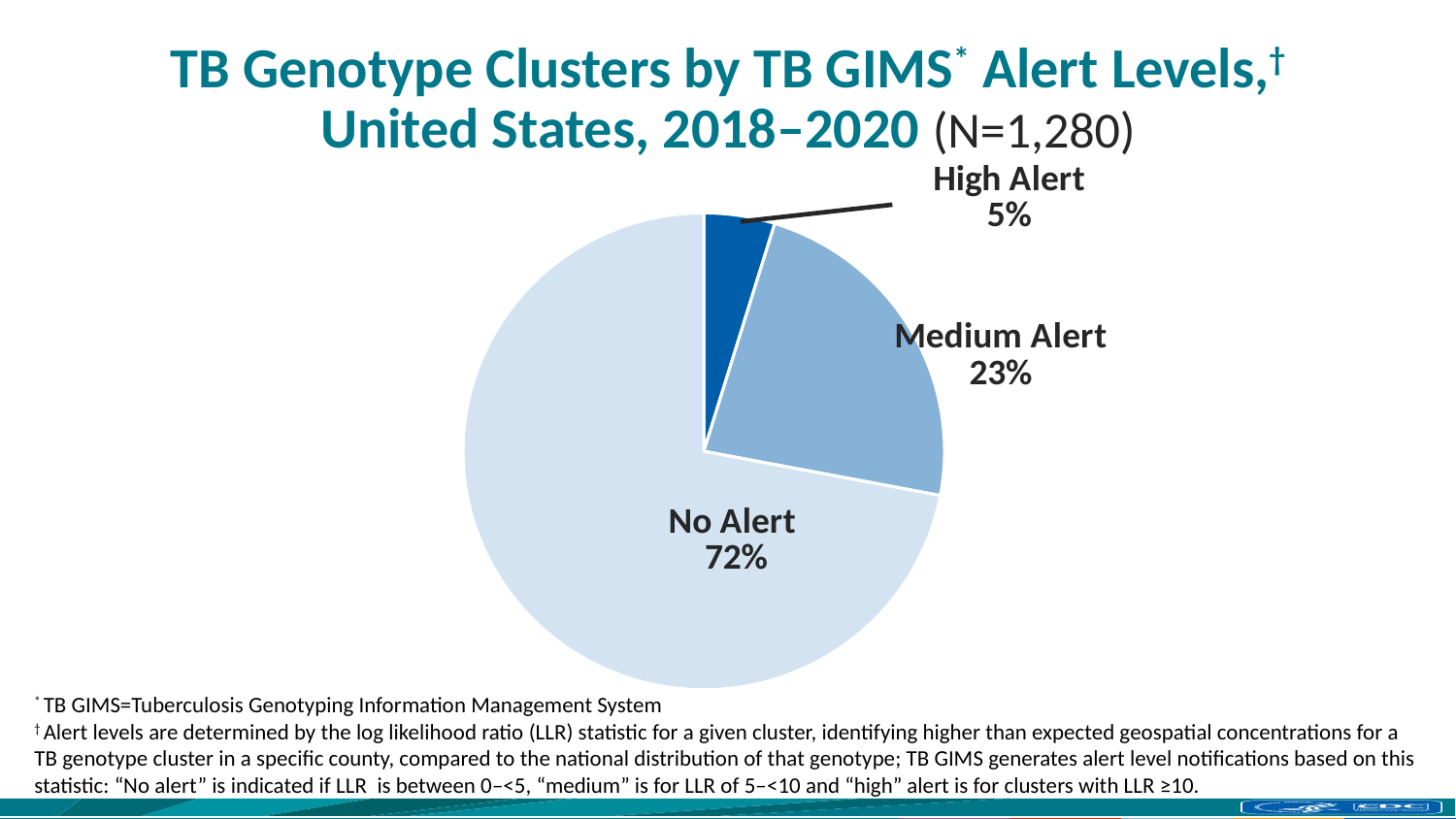
What percentage of TB genotype clusters had No Alert? 72% What is the difference in percentage points between the No Alert and Medium Alert slices? 49 What percentage of TB genotype clusters had High Alert? 5% What is the difference in percentage points between the Medium Alert and High Alert slices? 18 Which alert level has the smallest share of the pie? High Alert Which alert level has the largest share of the pie? No Alert What percentage of TB genotype clusters had Medium Alert? 23% How many slices does the pie chart have? 3 Which years does the chart cover according to its title? 2018–2020 What kind of chart is shown on the slide? pie chart What is the total number of TB genotype clusters (N) shown in the title? 1,280 Which is larger, the Medium Alert slice or the High Alert slice? Medium Alert